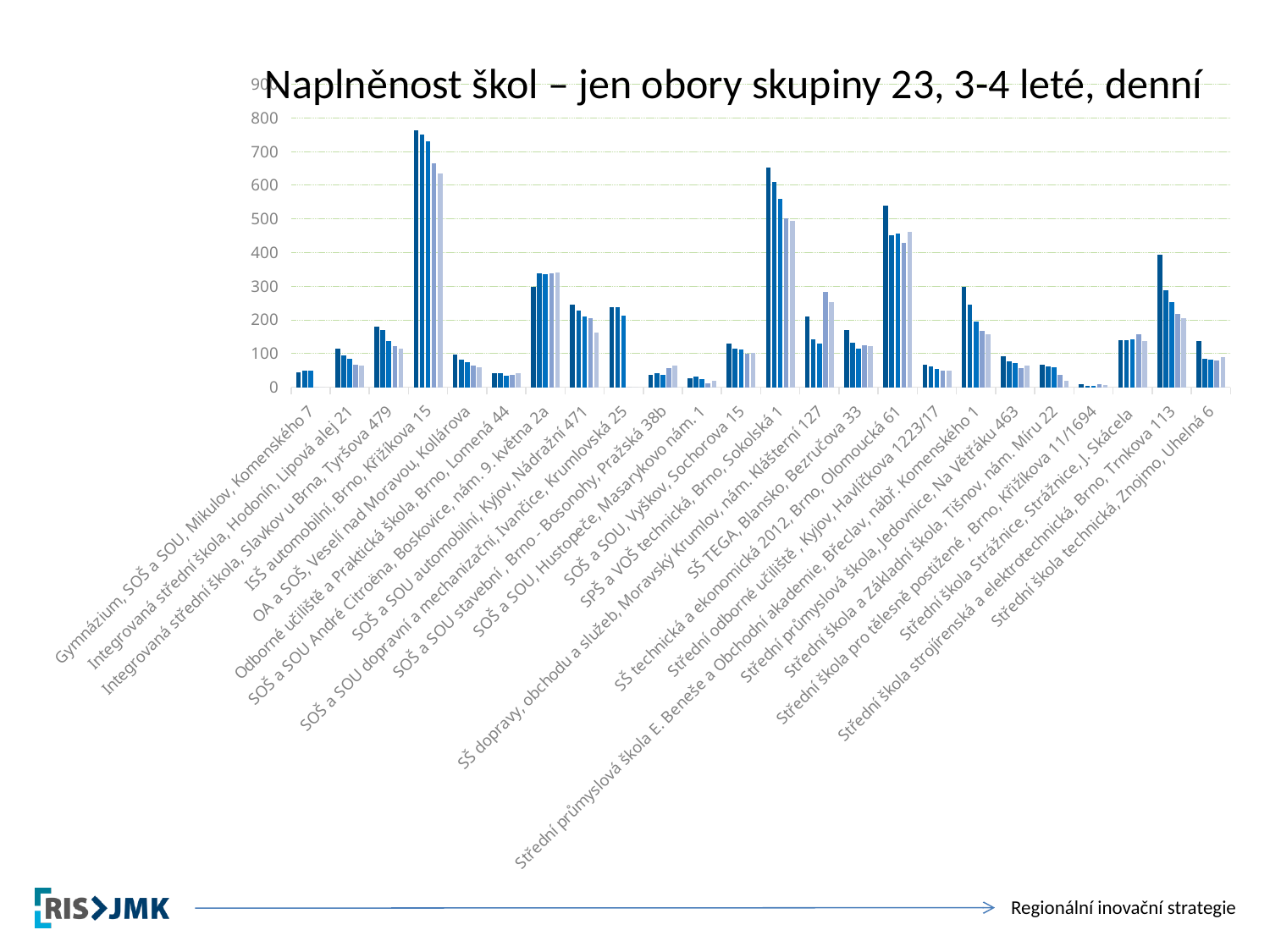
Is the tallest bar for ISŠ automobilní, Brno, Křižíkova 15 greater or less than 700? greater Is the tallest bar for Gymnázium, SOŠ a SOU, Mikulov, Komenského 7 greater or less than 100? less What is the title of the chart? Naplněnost škol – jen obory skupiny 23, 3-4 leté, denní Is the tallest bar for SŠ technická a ekonomická 2012, Brno, Olomoucká 61 greater or less than 500? greater What kind of chart is shown on the slide? bar chart Which school has higher bars: SOŠ a SOU, Hustopeče, Masarykovo nám. 1 or SOŠ a SOU, Vyškov, Sochorova 15? SOŠ a SOU, Vyškov, Sochorova 15 Which school has the tallest bar in the chart? ISŠ automobilní, Brno, Křižíkova 15 Which school has higher bars: ISŠ automobilní, Brno, Křižíkova 15 or SPŠ a VOŠ technická, Brno, Sokolská 1? ISŠ automobilní, Brno, Křižíkova 15 Which school has the lowest bars in the chart? Střední škola pro tělesně postižené, Brno, Křižíkova 11/1694 How many schools (categories) are shown on the x axis of the chart? 24